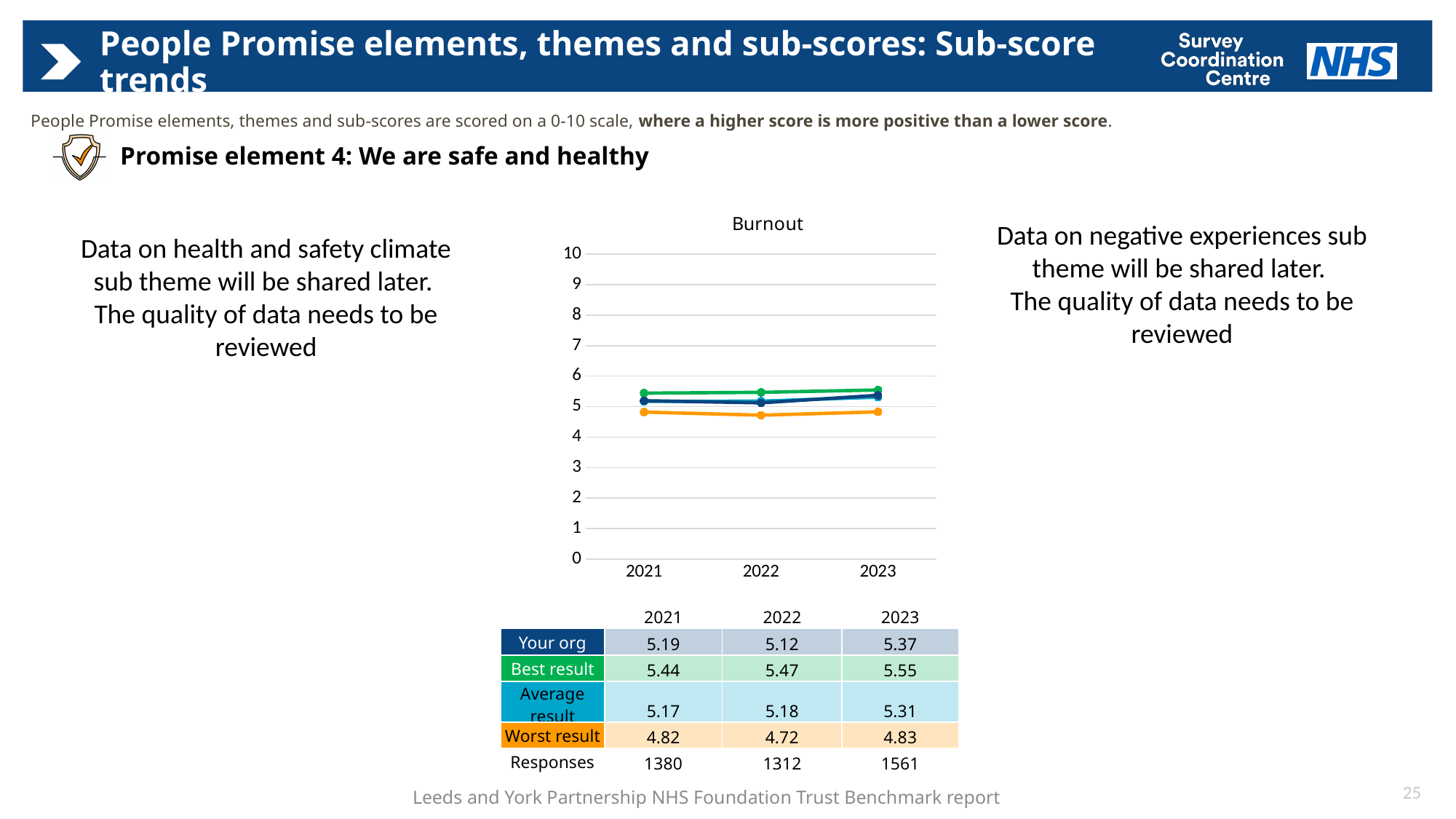
What kind of chart is shown? line chart What is the Best result value for 2021? 5.44 How many series are plotted in the chart? 4 Which is larger in 2022, the Your org value or the Average result value? Average result How many years are shown on the x axis? 3 In which year is the Your org value highest? 2023 In which year is the Worst result value lowest? 2022 Is the Worst result value for 2021 greater or less than 5? less What is the Worst result value for 2022? 4.72 What is the difference between the Best result and Your org values in 2023? 0.18 What is the Your org value for 2023? 5.37 What is the title of the chart? Burnout